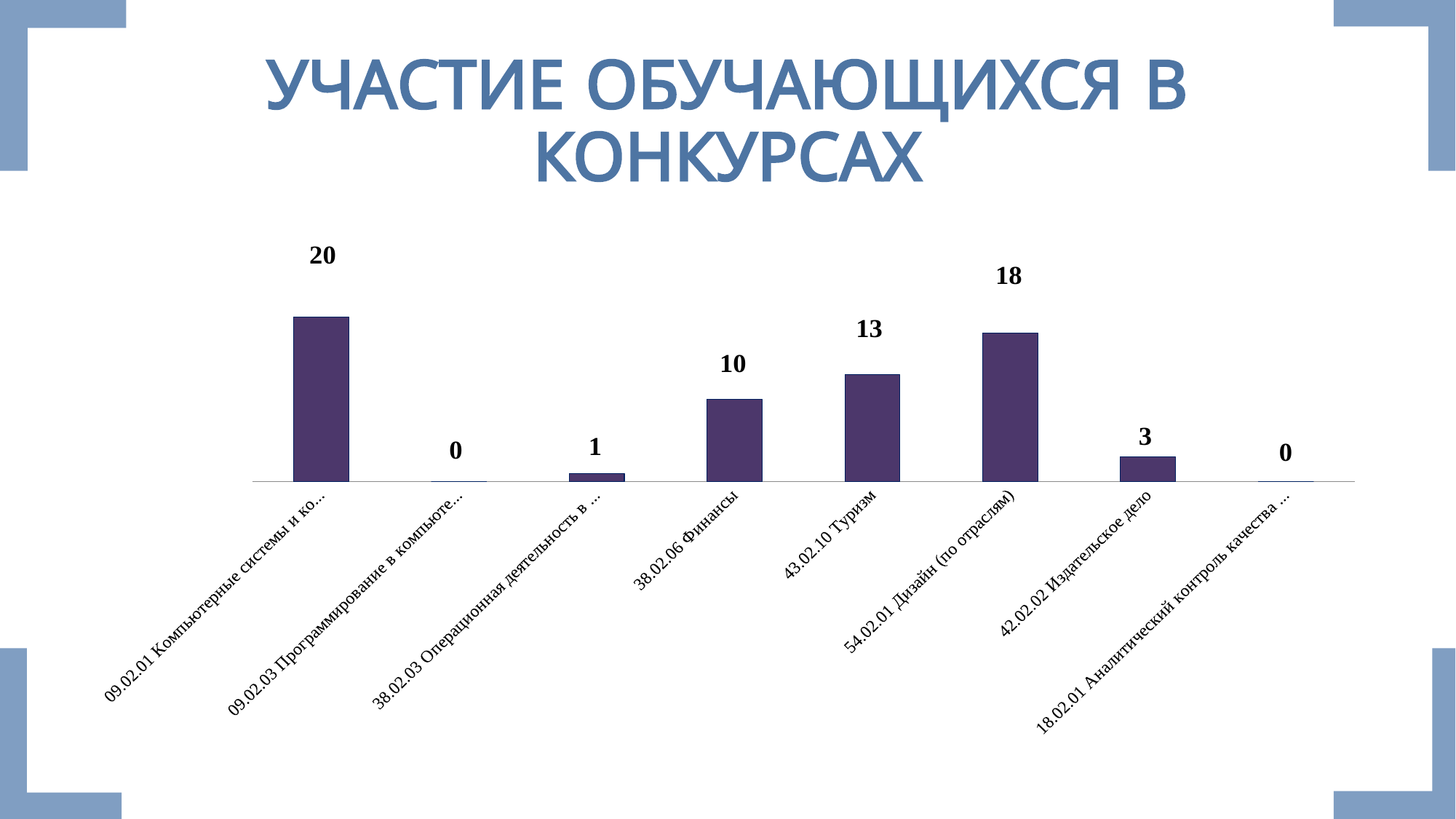
What is the difference between the values for 54.02.01 Дизайн (по отраслям) and 43.02.10 Туризм? 5 Which is larger, the value for 38.02.06 Финансы or the value for 42.02.02 Издательское дело? 38.02.06 Финансы What is the title of the slide containing the chart? УЧАСТИЕ ОБУЧАЮЩИХСЯ В КОНКУРСАХ How many categories have a value of 0? 2 Which category has the highest value? 09.02.01 Компьютерные системы и ко... What is the value for 42.02.02 Издательское дело? 3 How many categories are shown on the x axis? 8 What is the value for the category whose code is 09.02.01? 20 What is the value for 43.02.10 Туризм? 13 What is the value for 54.02.01 Дизайн (по отраслям)? 18 What is the value for 38.02.06 Финансы? 10 What type of chart is shown on the slide? bar chart